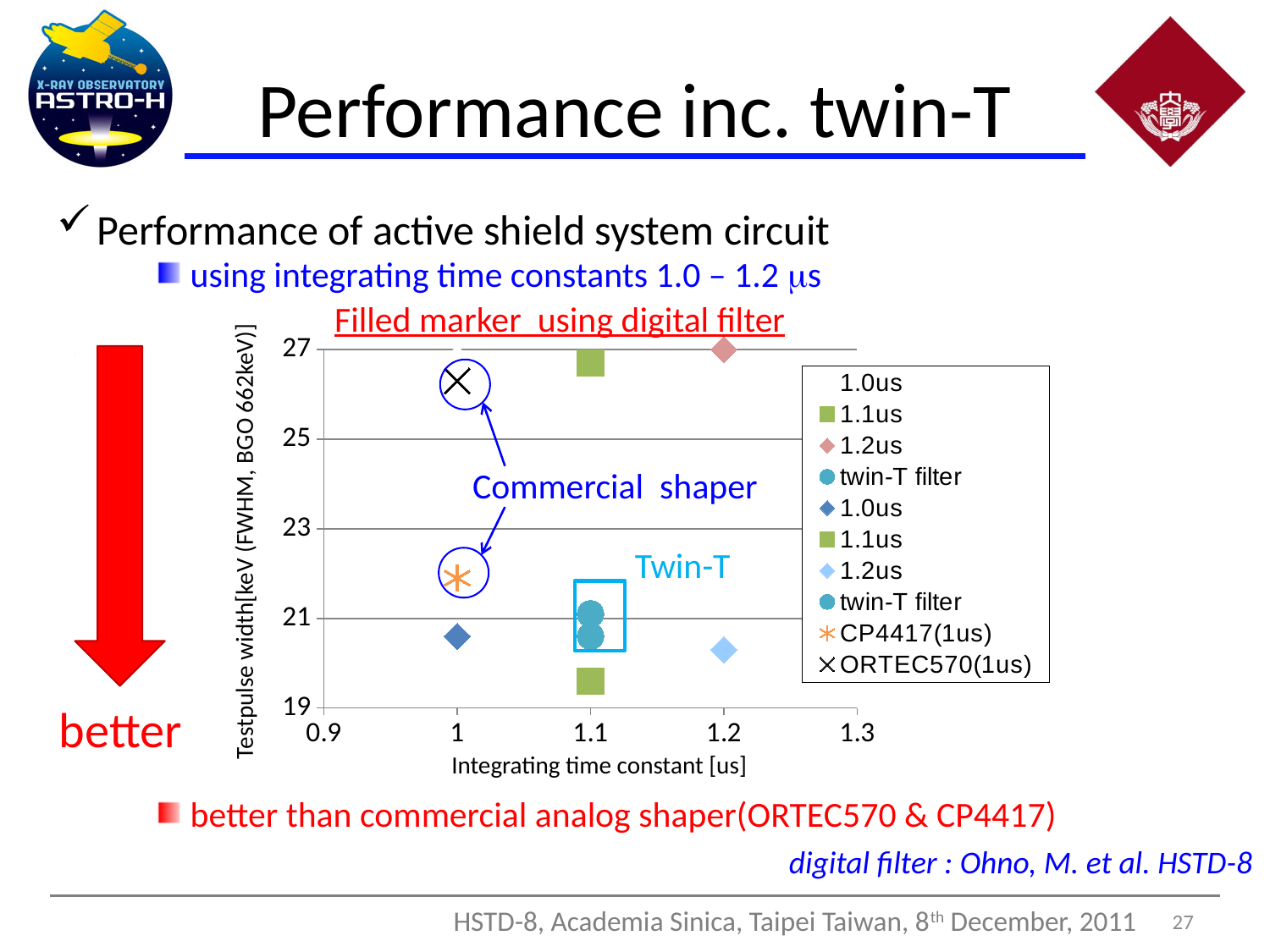
Is the value for CP4417(1us) greater or less than 23? less Is the value for the dark blue diamond 1.0us point greater or less than 21? less Which has the larger test pulse width, ORTEC570(1us) or the twin-T filter points? ORTEC570(1us) What kind of chart is shown on the slide? Scatter chart Is the value for ORTEC570(1us) greater or less than 25? greater What is the label of the y axis of the chart? Testpulse width[keV (FWHM, BGO 662keV)] What is the label of the x axis of the chart? Integrating time constant [us] How many entries does the chart legend list? 10 At which integrating time constant are the twin-T filter points plotted? 1.1 Which has the larger test pulse width, ORTEC570(1us) or CP4417(1us)? ORTEC570(1us)